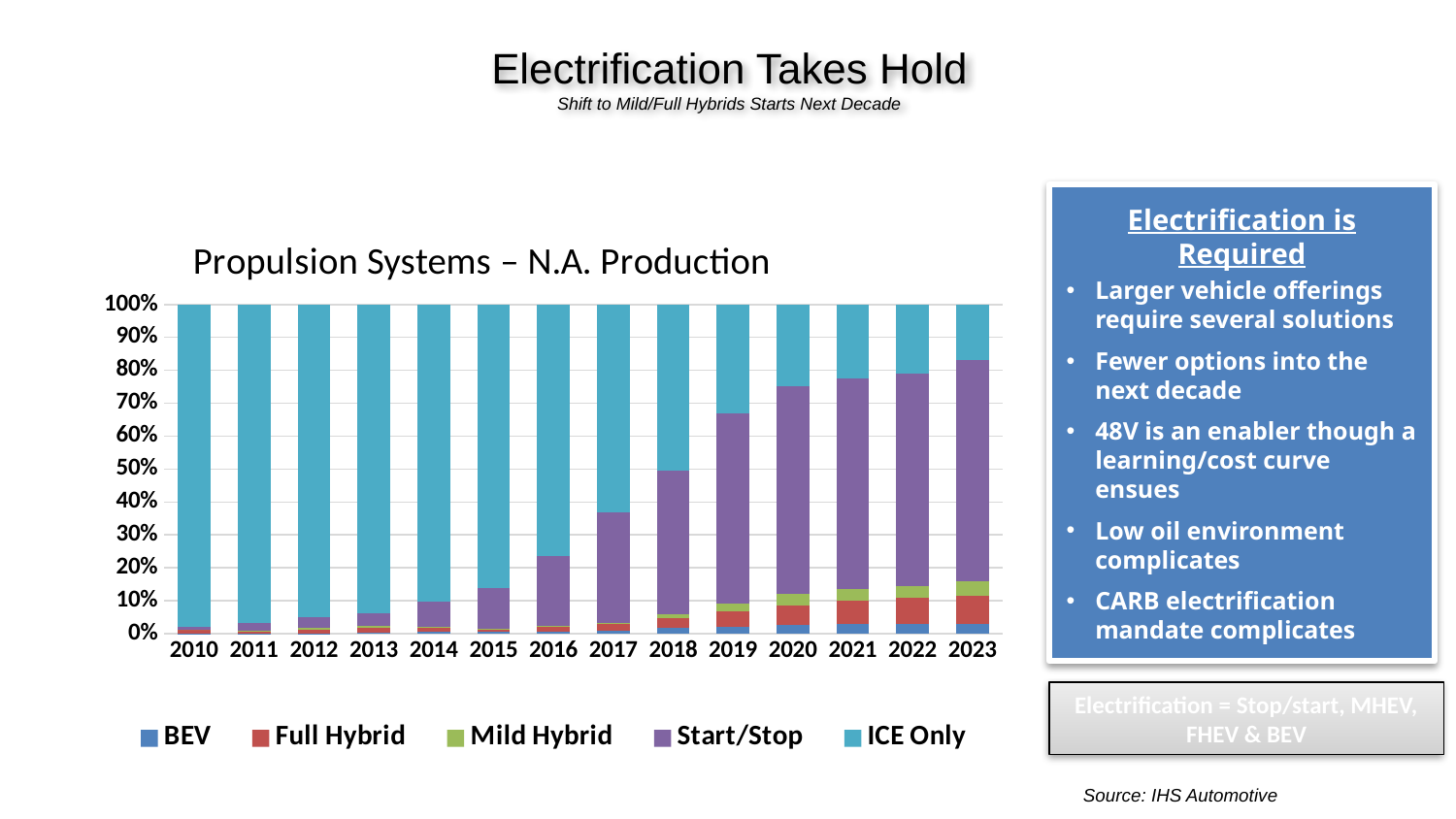
Which year has the larger Start/Stop share, 2010 or 2023? 2023 Does the ICE Only share rise or fall from 2010 to 2023? Fall What is the title of the chart on the slide? Propulsion Systems – N.A. Production What does each stacked bar in the chart total? 100% How many years are shown along the x axis of the chart? 14 Does the Start/Stop share rise or fall from 2010 to 2023? Rise Is the Start/Stop share in 2020 greater or less than 50%? greater How many series does the chart legend list? 5 What type of chart is shown on the slide? Stacked bar chart Which series is listed last in the chart legend? ICE Only Is the ICE Only share in 2023 greater or less than 30%? less Is the ICE Only share in 2010 greater or less than 90%? greater